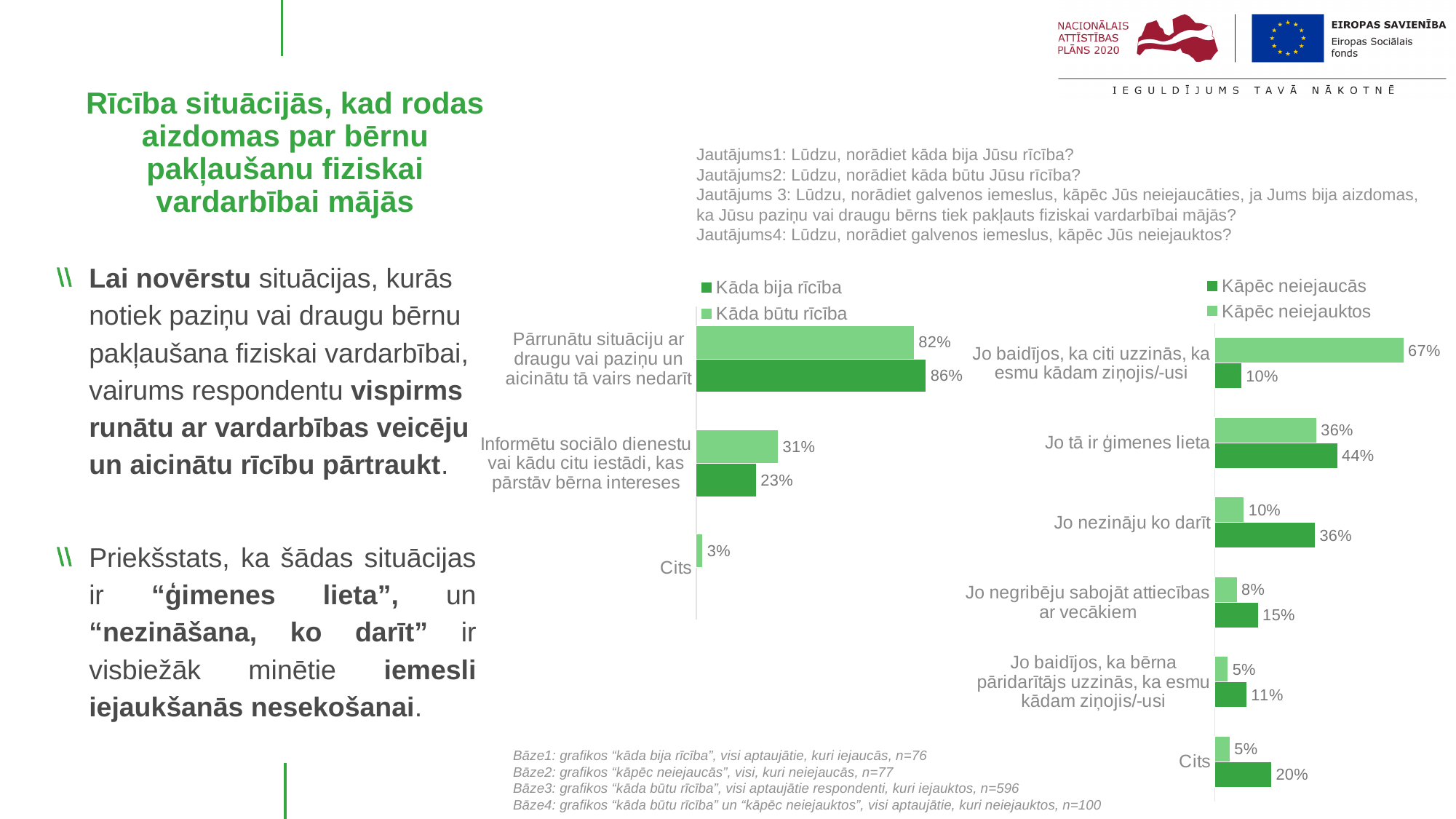
How many series does the legend of the left chart list? 2 In the left chart, what is the value shown for "Cits"? 3% In the left chart, what is the value of "Kāda bija rīcība" for "Pārrunātu situāciju ar draugu vai paziņu un aicinātu tā vairs nedarīt"? 86% In the left chart, what is the difference between the "Kāda būtu rīcība" and "Kāda bija rīcība" values for "Informētu sociālo dienestu vai kādu citu iestādi, kas pārstāv bērna intereses"? 8% How many categories are shown in the right chart? 6 In the right chart, what is the value of "Kāpēc neiejaucās" for "Jo tā ir ģimenes lieta"? 44% In the right chart, which category has the highest "Kāpēc neiejaucās" value? Jo tā ir ģimenes lieta In the right chart, which category has the highest "Kāpēc neiejauktos" value? Jo baidījos, ka citi uzzinās, ka esmu kādam ziņojis/-usi In the right chart, what is the value of "Kāpēc neiejauktos" for "Jo baidījos, ka citi uzzinās, ka esmu kādam ziņojis/-usi"? 67% What type of chart is the right chart? Bar chart In the left chart, what is the value of "Kāda būtu rīcība" for "Informētu sociālo dienestu vai kādu citu iestādi, kas pārstāv bērna intereses"? 31% In the right chart, which is larger for "Jo nezināju ko darīt": "Kāpēc neiejaucās" or "Kāpēc neiejauktos"? Kāpēc neiejaucās